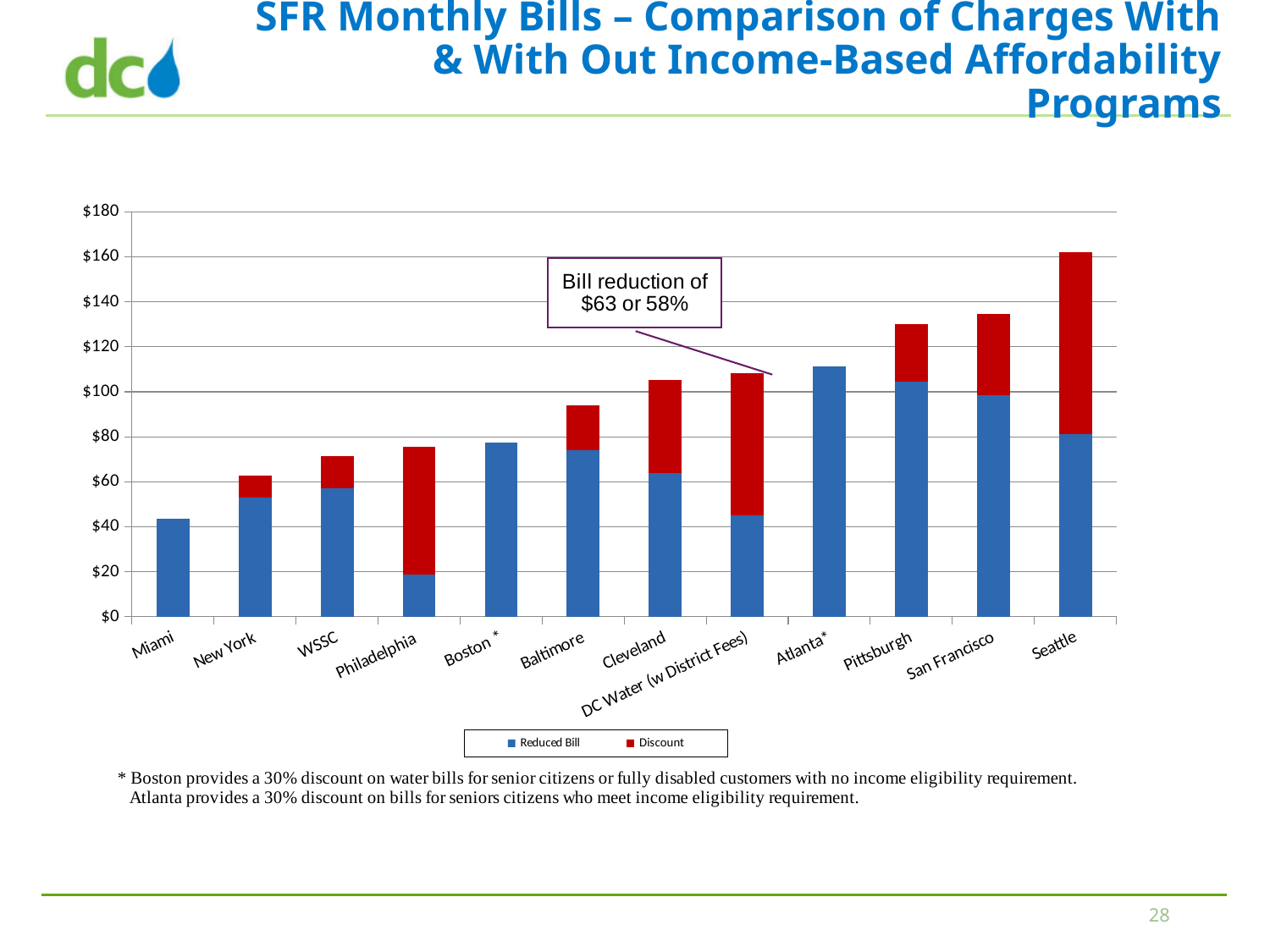
Do the total bar heights generally rise or fall moving from left to right along the x axis? rise Is the value for Miami greater or less than $60? less What are the two series named in the chart's legend? Reduced Bill and Discount Which city has the highest total monthly bill in the chart? Seattle How many cities or utilities are shown along the x axis of the chart? 12 Which city has the lowest total monthly bill in the chart? Miami Is the value for Atlanta* greater or less than $100? greater Is the total bar for Seattle greater or less than $140? greater Which has the larger total monthly bill, Seattle or Pittsburgh? Seattle How many series does the chart's legend list? 2 According to the annotation on the chart, what is the bill reduction for DC Water (w District Fees)? $63 or 58% What kind of chart is shown on the slide? stacked bar chart